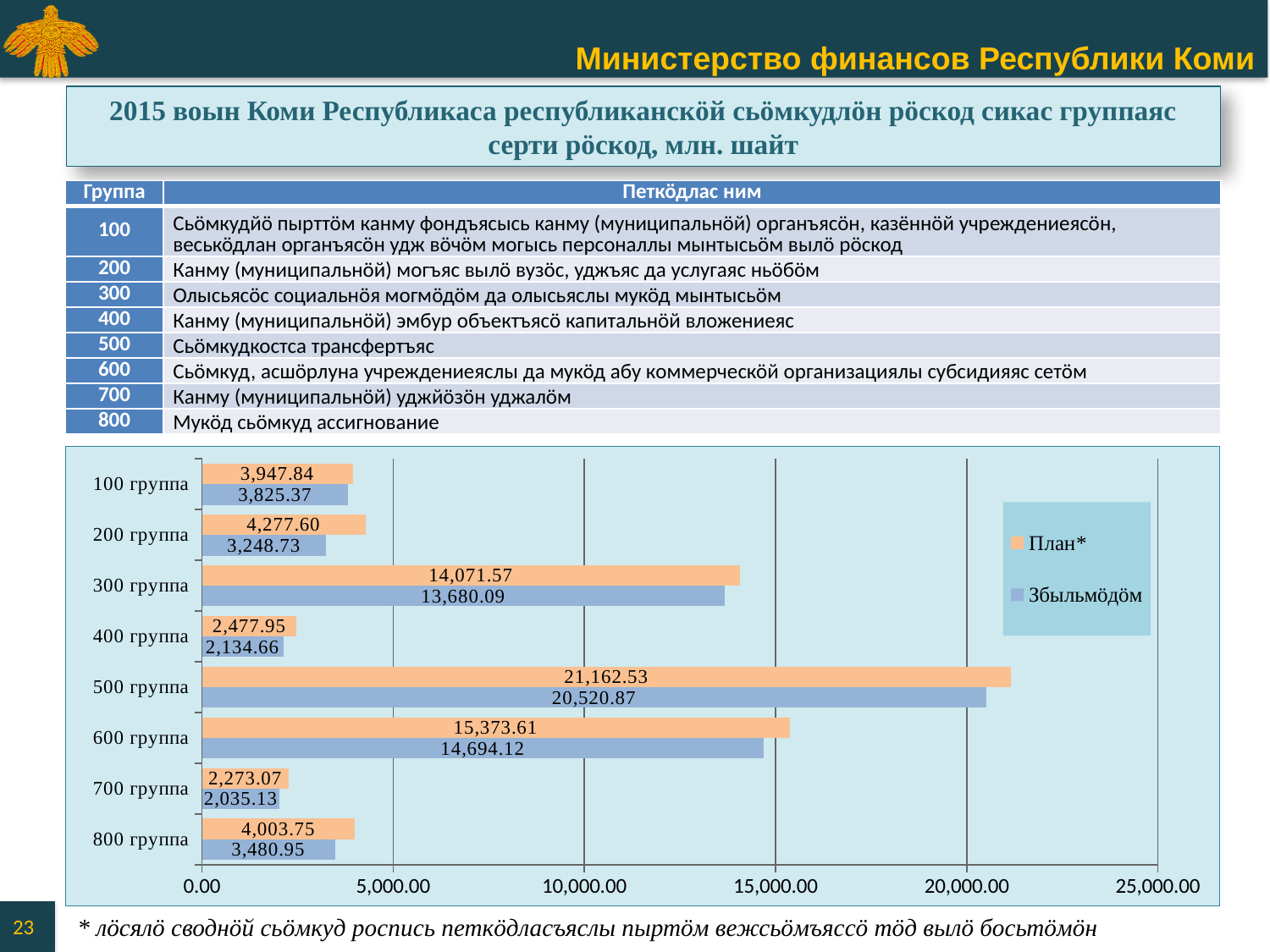
Is the Збыльмӧдӧм value for 300 группа greater or less than 15,000.00? less What kind of chart is shown on the slide? bar chart What is the План* value for 500 группа? 21,162.53 What is the difference between the План* and Збыльмӧдӧм values for 100 группа? 122.47 Which group has the highest План* value? 500 группа Which group has the lowest Збыльмӧдӧм value? 700 группа What is the План* value for 800 группа? 4,003.75 What is the Збыльмӧдӧм value for 300 группа? 13,680.09 Which is larger: the Збыльмӧдӧм value for 200 группа or the Збыльмӧдӧм value for 800 группа? 800 группа What is the difference between the План* and Збыльмӧдӧм values for 500 группа? 641.66 How many series does the chart legend list? 2 How many groups are shown on the chart? 8